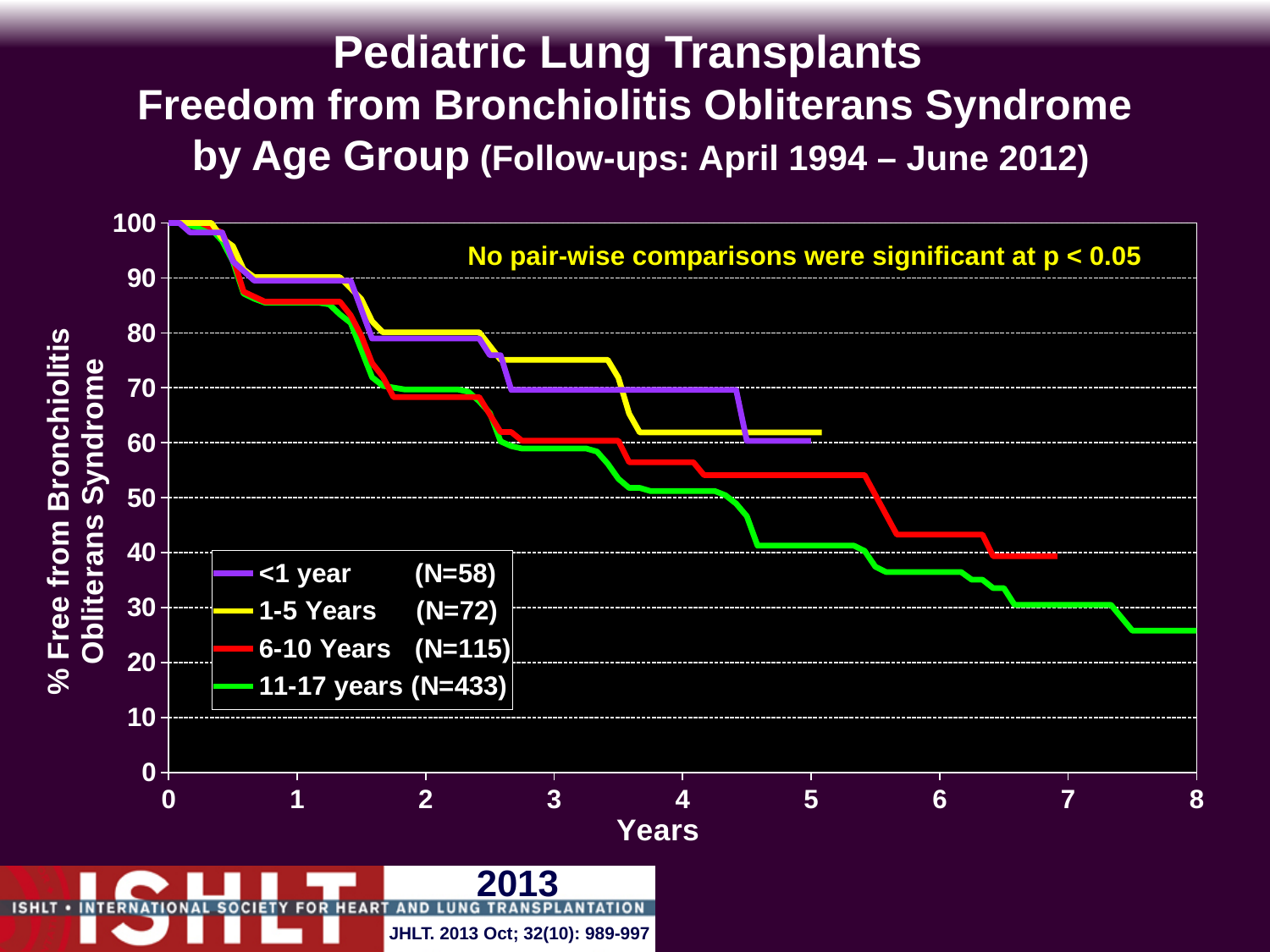
Do the curves rise or fall as years increase along the x axis? fall Which age group has the smallest N in the legend? <1 year Which age group has the largest N in the legend? 11-17 years What is the N value for the <1 year group in the legend? N=58 Which series extends furthest along the x axis? 11-17 years Is the value for the <1 year group at 4 years greater or less than 60? greater What kind of chart is shown on the slide? line chart What is the N value for the 11-17 years group in the legend? N=433 How many series does the legend list? 4 Is the value for the 11-17 years group at 8 years greater or less than 30? less Is the value for the 11-17 years group at 6 years greater or less than 40? less At 6 years, which group has the higher value: 6-10 Years or 11-17 years? 6-10 Years